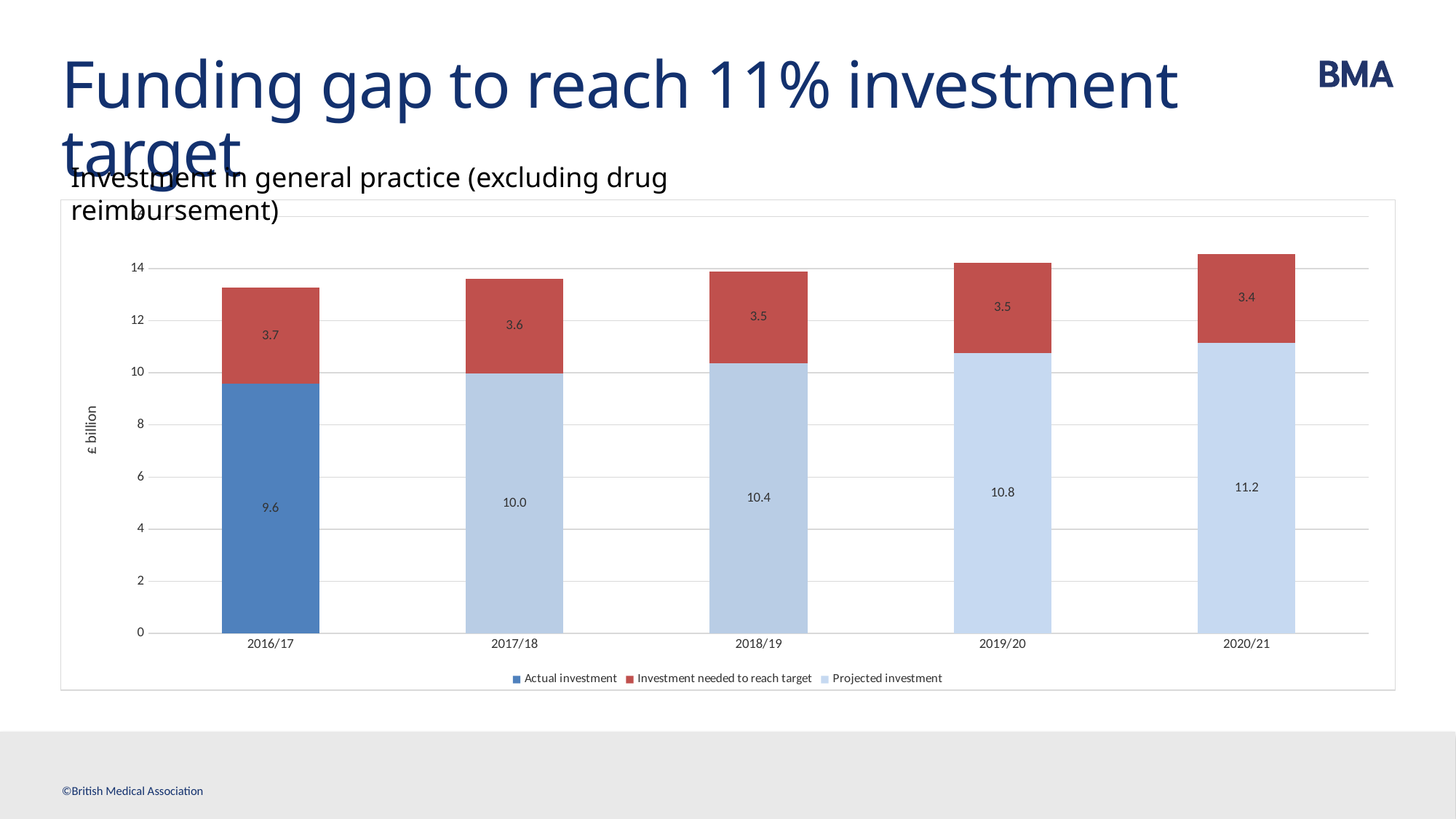
What is the value of 'Actual investment' for 2016/17? 9.6 What is the label on the vertical axis? £ billion What is the value of 'Investment needed to reach target' for 2016/17? 3.7 Which is larger: the 'Investment needed to reach target' for 2017/18 or for 2020/21? 2017/18 What is the difference between the 'Projected investment' values for 2020/21 and 2017/18? 1.2 What is the total of the stacked bar for 2018/19? 13.9 How many series does the legend list? 3 How many years are shown on the x axis? 5 Which year has the lowest 'Investment needed to reach target' value? 2020/21 What kind of chart is shown on the slide? Stacked bar chart What is the value of 'Projected investment' for 2019/20? 10.8 Which year has the highest 'Projected investment' value? 2020/21